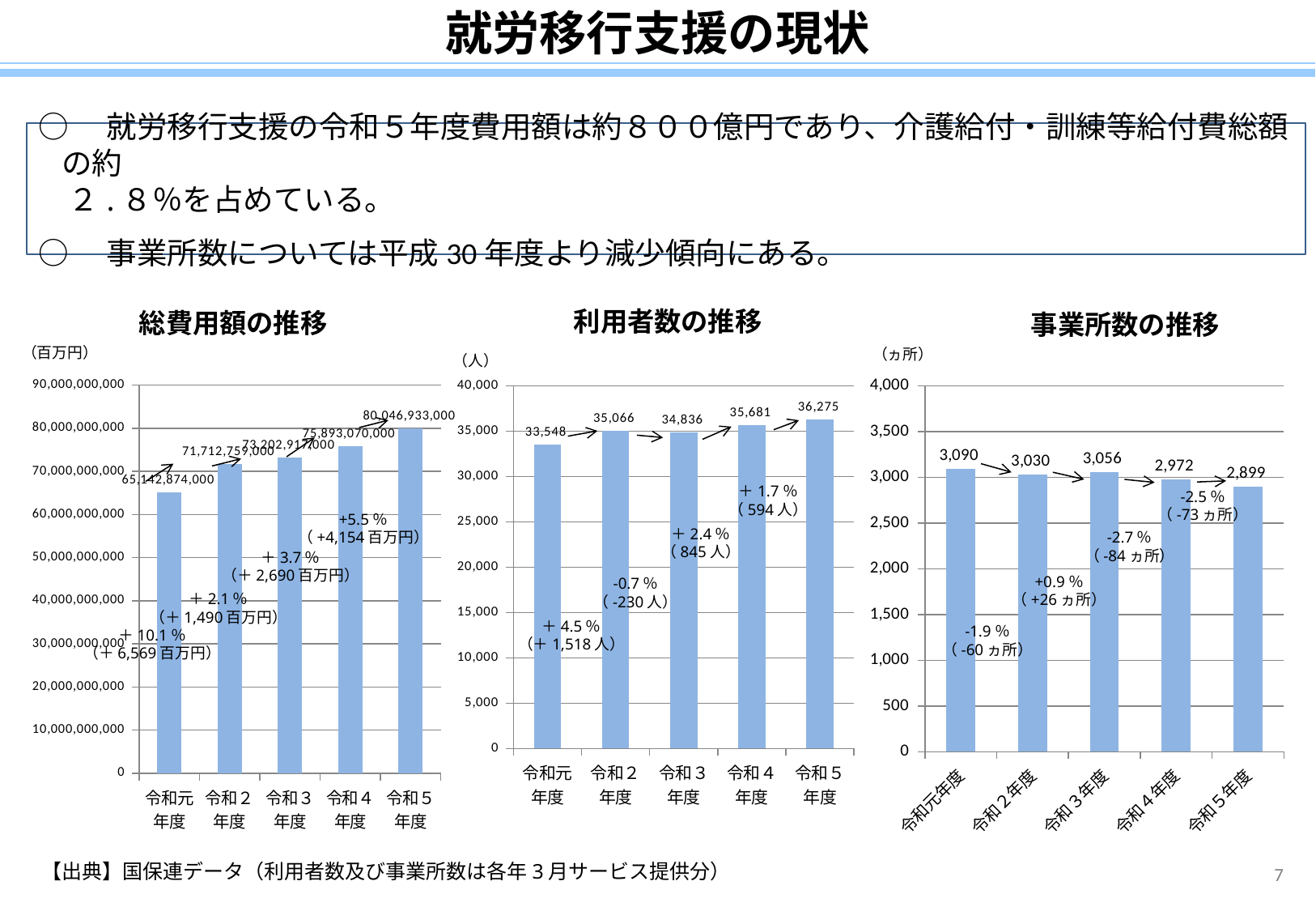
In the 利用者数の推移 chart, what is the value for 令和元年度? 33,548 In the 総費用額の推移 chart, what is the value for 令和５年度? 80,046,933,000 In the 事業所数の推移 chart, what is the difference between the values for 令和元年度 and 令和５年度? 191 In the 総費用額の推移 chart, is the value for 令和元年度 greater or less than 70,000,000,000? less In the 利用者数の推移 chart, what is the value for 令和５年度? 36,275 How many bars are in the 事業所数の推移 chart? 5 What kind of chart is the 総費用額の推移 chart? bar chart In the 利用者数の推移 chart, which is larger, the value for 令和２年度 or 令和３年度? 令和２年度 In the 事業所数の推移 chart, what is the value for 令和３年度? 3,056 In the 利用者数の推移 chart, what is the difference between the values for 令和４年度 and 令和３年度? 845 In the 利用者数の推移 chart, which year has the highest value? 令和５年度 In the 事業所数の推移 chart, which year has the lowest value? 令和５年度